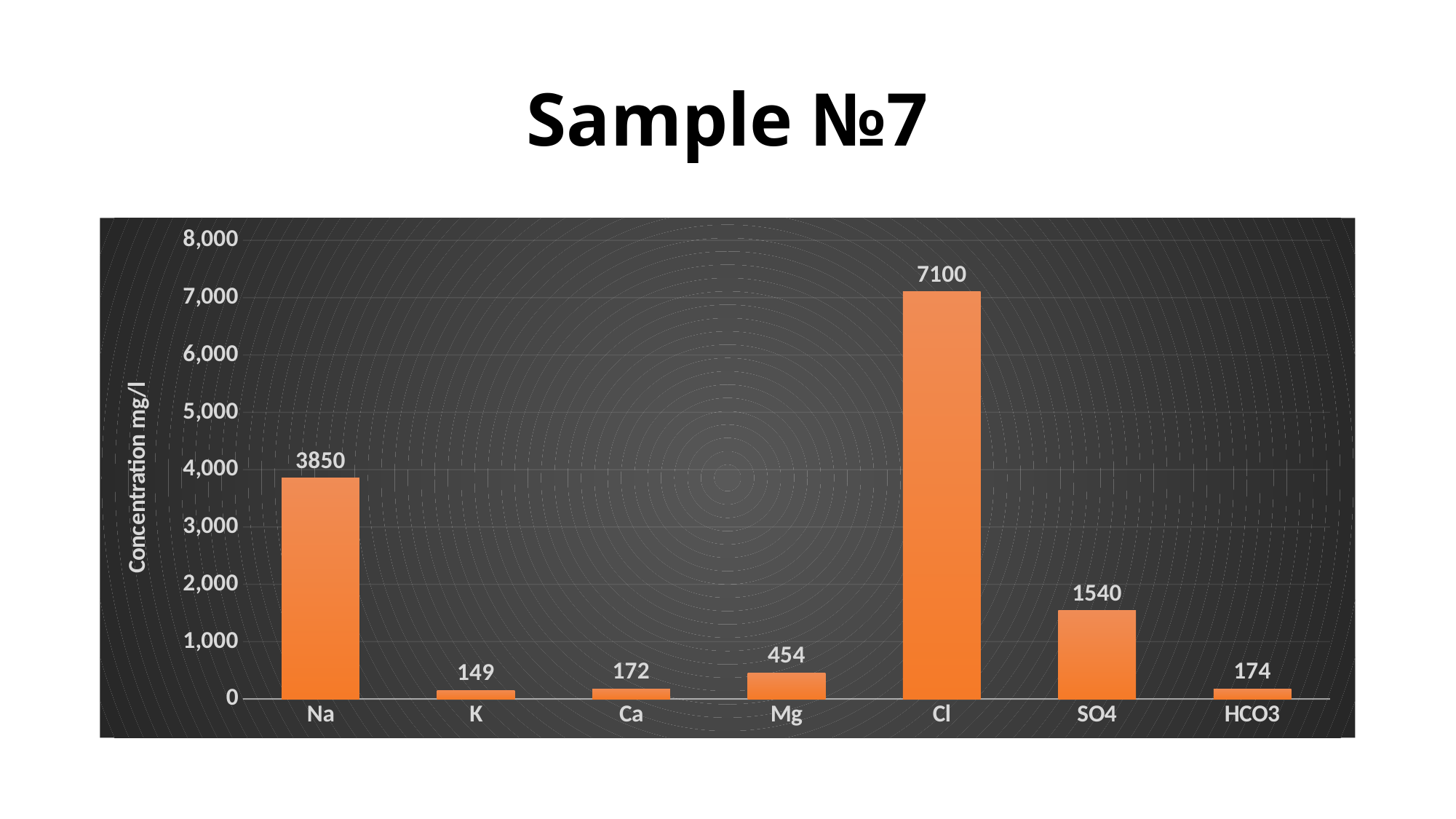
What is the difference between the concentrations of HCO3 and Ca? 2 Which has a higher concentration, SO4 or Mg? SO4 Which ion has the lowest concentration? K What is the concentration of Cl? 7100 What kind of chart is shown on the slide? Bar chart Which ion has the highest concentration? Cl How many ions are shown on the chart? 7 What is the concentration of Na? 3850 What is the label of the vertical axis? Concentration mg/l What is the concentration of SO4? 1540 What is the concentration of Mg? 454 What is the difference between the concentrations of Cl and Na? 3250